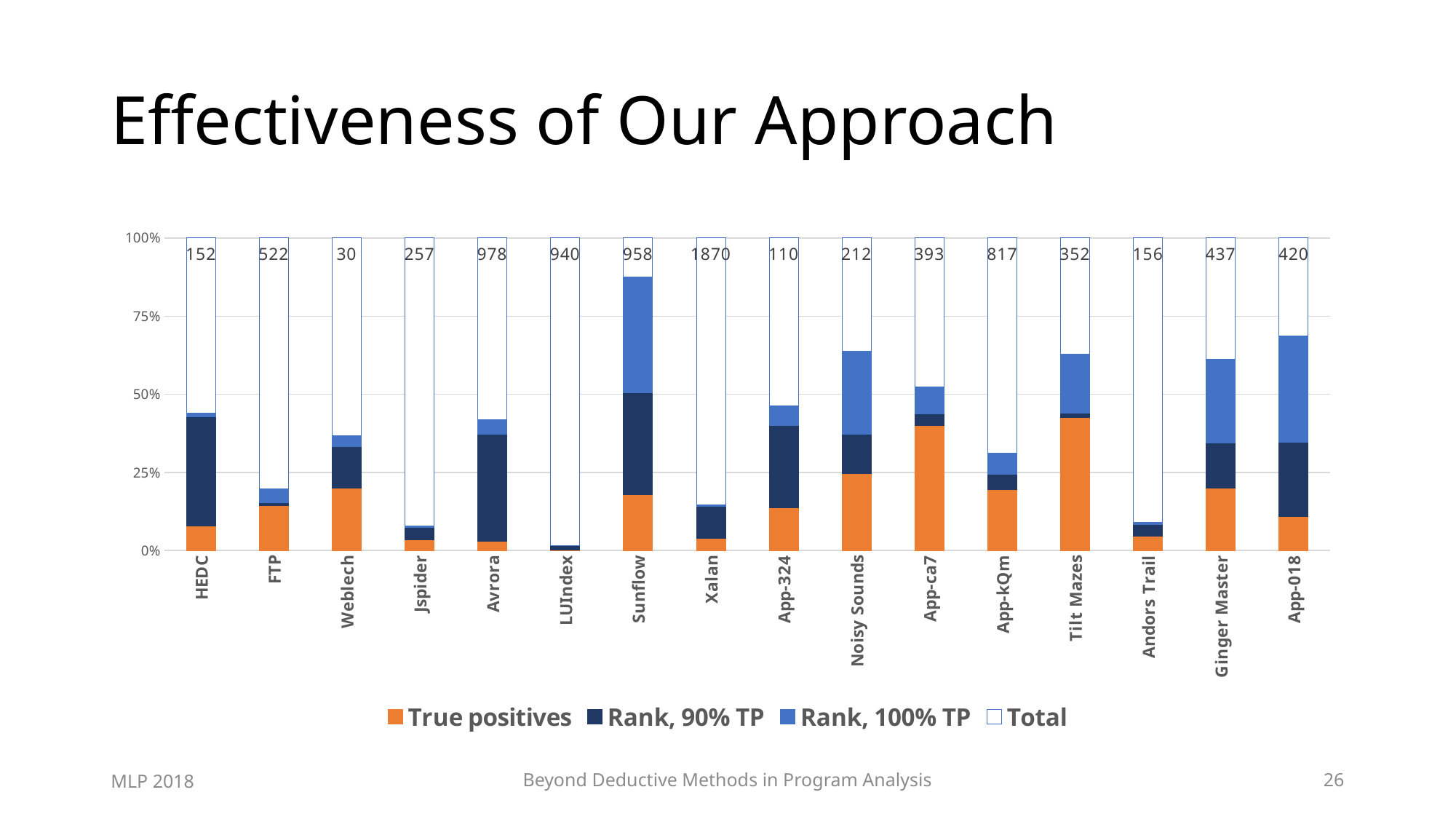
What is the Total value printed above the bar for Sunflow? 958 Which has a larger printed Total value, Sunflow or App-kQm? Sunflow Which category has the lowest printed Total value? Weblech How many categories (benchmarks) are shown along the x axis? 16 What is the Total value printed above the bar for Weblech? 30 Which category has the highest printed Total value? Xalan How many series does the legend list? 4 What kind of chart is shown on the slide? bar chart What is the difference between the printed Total values for Avrora and LUIndex? 38 Is the True positives share for Tilt Mazes greater or less than 25%? greater What is the Total value printed above the bar for Xalan? 1870 What is the title of the slide containing the chart? Effectiveness of Our Approach